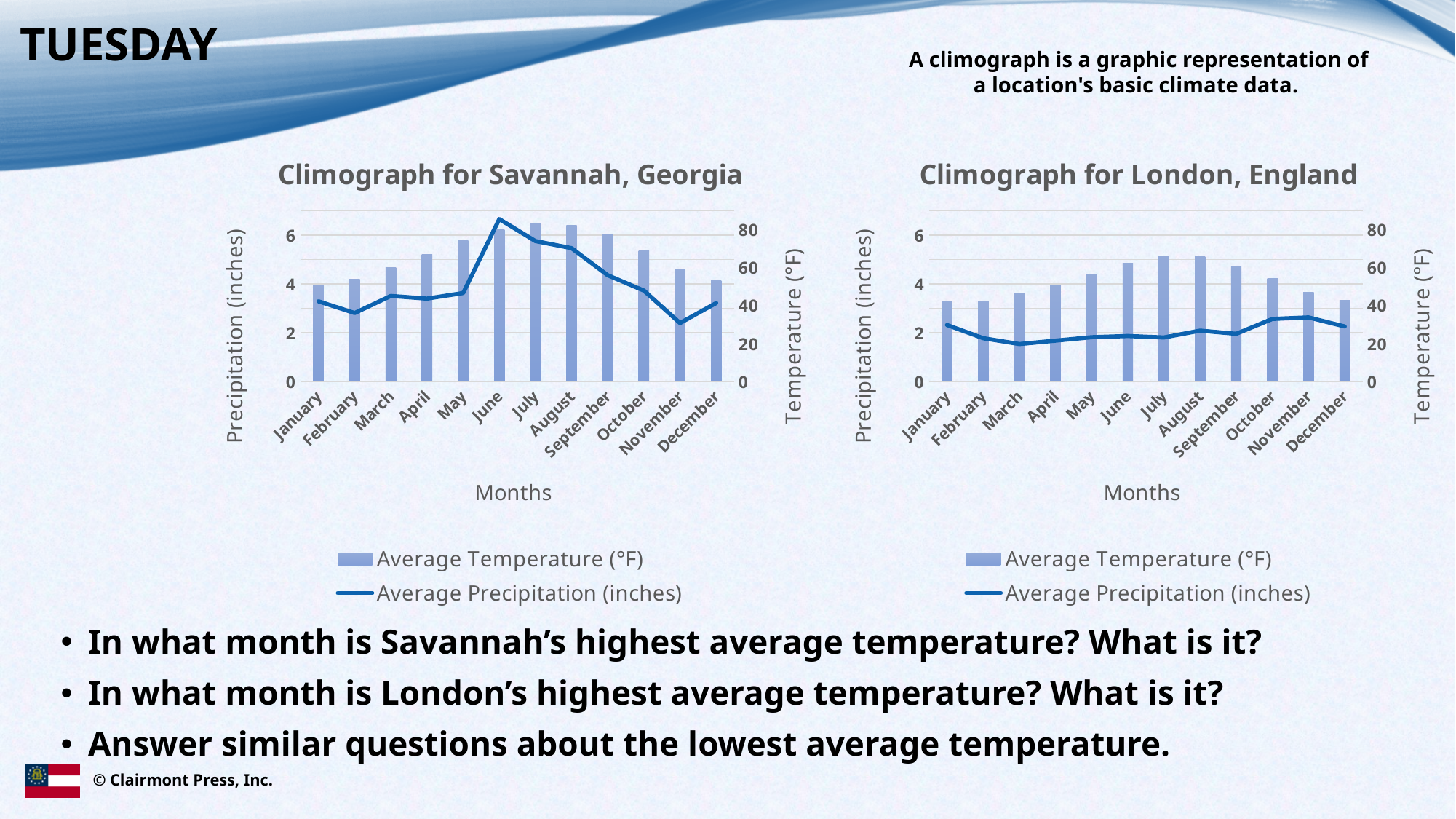
In the Climograph for Savannah, Georgia, is the average temperature for July greater or less than 80? greater In the Climograph for Savannah, Georgia, does the average temperature rise or fall from January to July? rise In the Climograph for Savannah, Georgia, which month has the lowest average precipitation? November What kind of chart is the Climograph for Savannah, Georgia? A combined bar and line chart In the Climograph for London, England, is the average temperature for January greater or less than 60? less In the Climograph for Savannah, Georgia, which month has the highest average precipitation? June How many series does the legend of the Climograph for London, England list? 2 Which is larger: the average temperature for July in the Climograph for Savannah, Georgia, or the average temperature for July in the Climograph for London, England? Savannah, Georgia In the Climograph for London, England, is the average precipitation for March greater or less than 2? less How many months are shown on the x axis of the Climograph for Savannah, Georgia? 12 Which series in the Climograph for London, England is drawn as a line? Average Precipitation (inches)